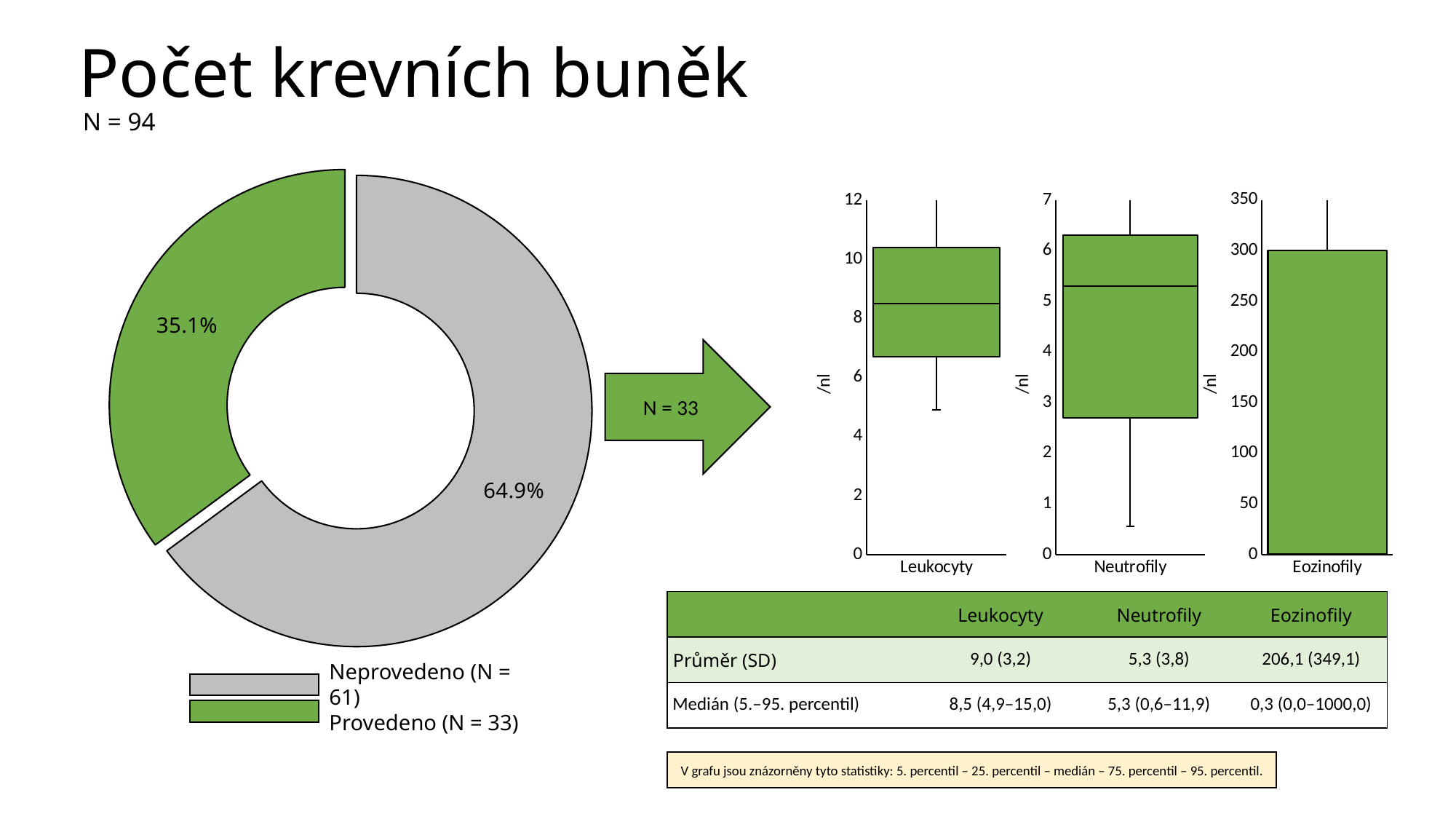
How many slices does the donut chart have? 2 What kind of chart is the chart on the left of the slide? Donut chart In the donut chart, what is the difference in percentage points between the Neprovedeno and Provedeno slices? 29.8 In the donut chart legend, what N is given for Provedeno? N = 33 In the Eozinofily box plot, is the top of the box greater or less than 250? greater In the donut chart legend, what colour is used for Neprovedeno? Grey In the donut chart, which slice is larger, Neprovedeno or Provedeno? Neprovedeno In the donut chart, what percentage is shown for the Provedeno slice? 35.1% In the Neutrofily box plot, is the lower whisker end greater or less than 1? less In the Leukocyty box plot, is the median line greater or less than 6? greater What kind of charts are the three charts on the right of the slide (Leukocyty, Neutrofily, Eozinofily)? Box plots In the donut chart, what percentage is shown for the Neprovedeno slice? 64.9%